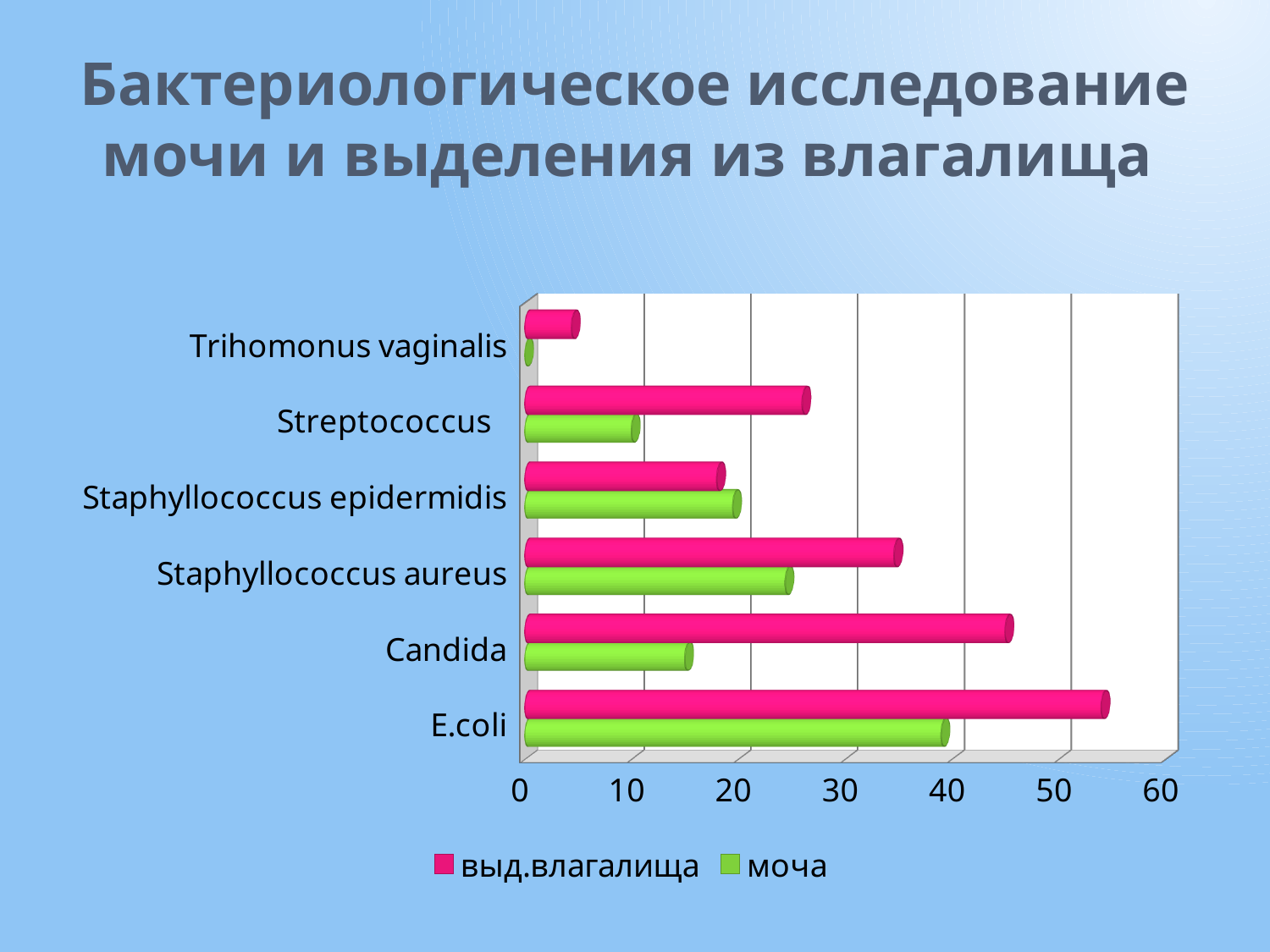
Is the value for Staphyllococcus aureus in the выд.влагалища series greater or less than 30? greater Which category has the lowest value for выд.влагалища? Trihomonus vaginalis For Candida, which series has the larger value: выд.влагалища or моча? выд.влагалища How many categories (microorganisms) are shown on the chart? 6 What kind of chart is shown on the slide? bar chart Which category has the highest value for выд.влагалища? E.coli Which colour represents the моча series in the chart? green Which category has the highest value for моча? E.coli Is the value for Candida in the моча series greater or less than 20? less Is the value for Streptococcus in the выд.влагалища series greater or less than 20? greater How many series does the legend list? 2